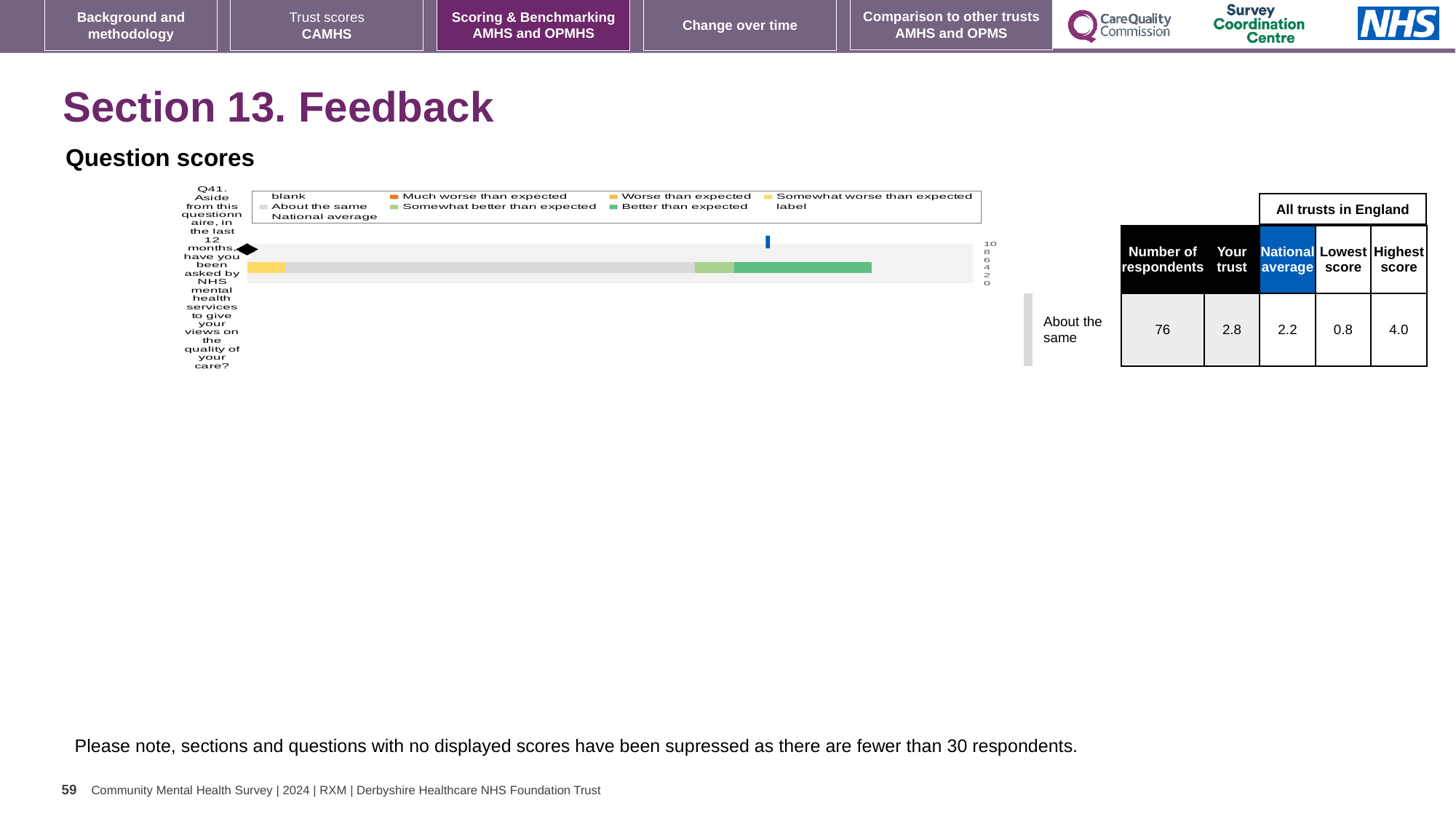
What is the national average score shown for Q41? 2.2 For Q41, which is larger: the 'Your trust' score or the national average? Your trust For Q41, what is the difference between the highest score and the lowest score across all trusts in England? 3.2 What benchmark category is shown next to the Q41 bar? About the same What is the lowest score across all trusts in England shown for Q41? 0.8 What is the highest value shown on the chart's axis? 10 What is the highest score across all trusts in England shown for Q41? 4.0 What is the 'Your trust' score shown for Q41? 2.8 What kind of chart is used to show the Q41 question scores? bar chart For Q41, how much higher is the 'Your trust' score than the national average? 0.6 What is the number of respondents shown for Q41? 76 How many questions are plotted in the Question scores chart? 1